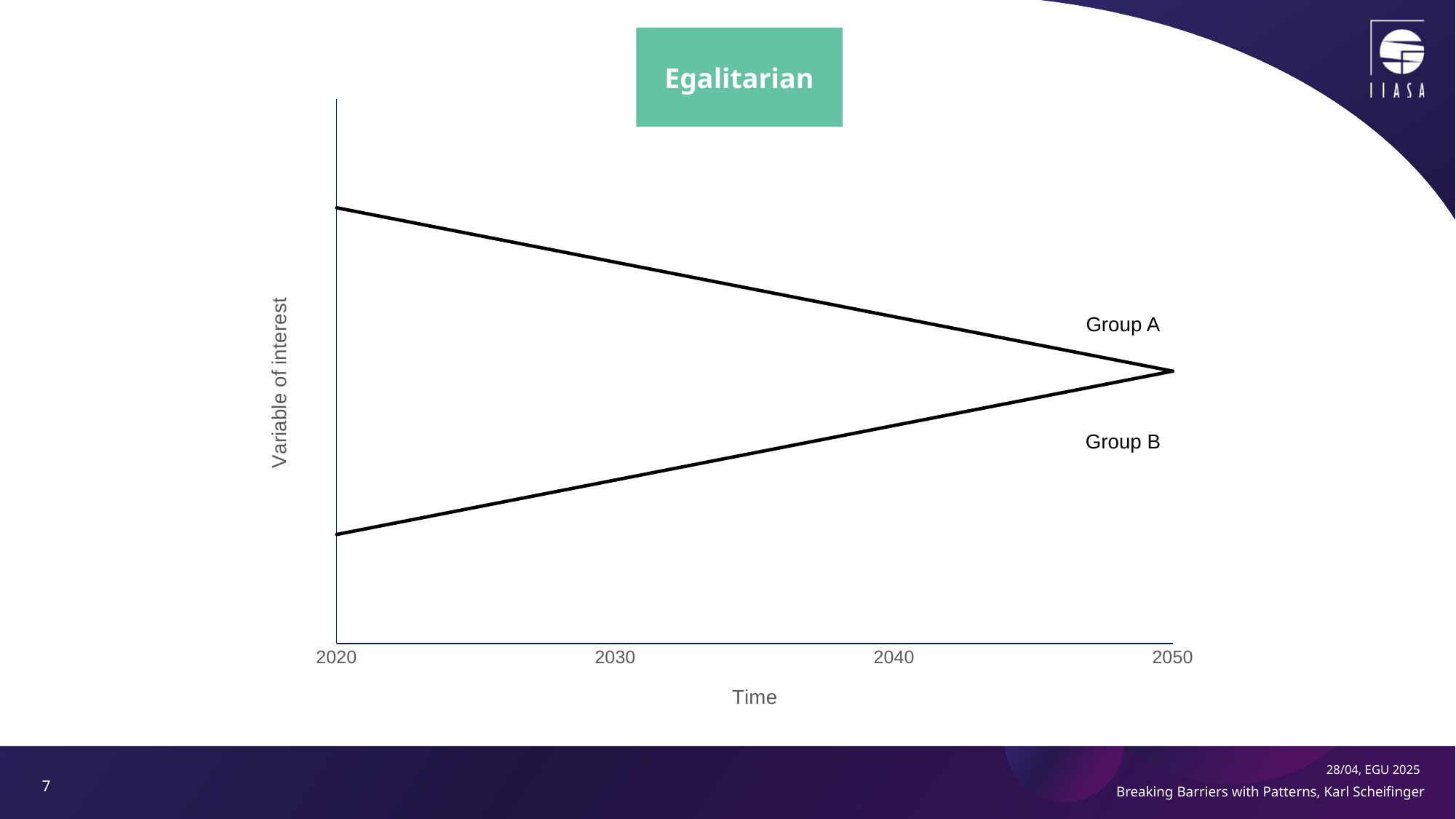
Does the Group B line rise or fall from 2020 to 2050? Rise What is the title shown above the chart? Egalitarian What kind of chart is shown on the slide? Line chart What is the last year shown on the x axis? 2050 How many lines (groups) are plotted on the chart? 2 In 2020, which group has the lower value of the variable of interest? Group B Does the Group A line rise or fall from 2020 to 2050? Fall What happens to the values of Group A and Group B by 2050? They become equal (the lines converge) In 2020, which group has the higher value of the variable of interest, Group A or Group B? Group A What is the label of the y axis? Variable of interest How many year labels are shown on the x axis? 4 What is the first year shown on the x axis? 2020